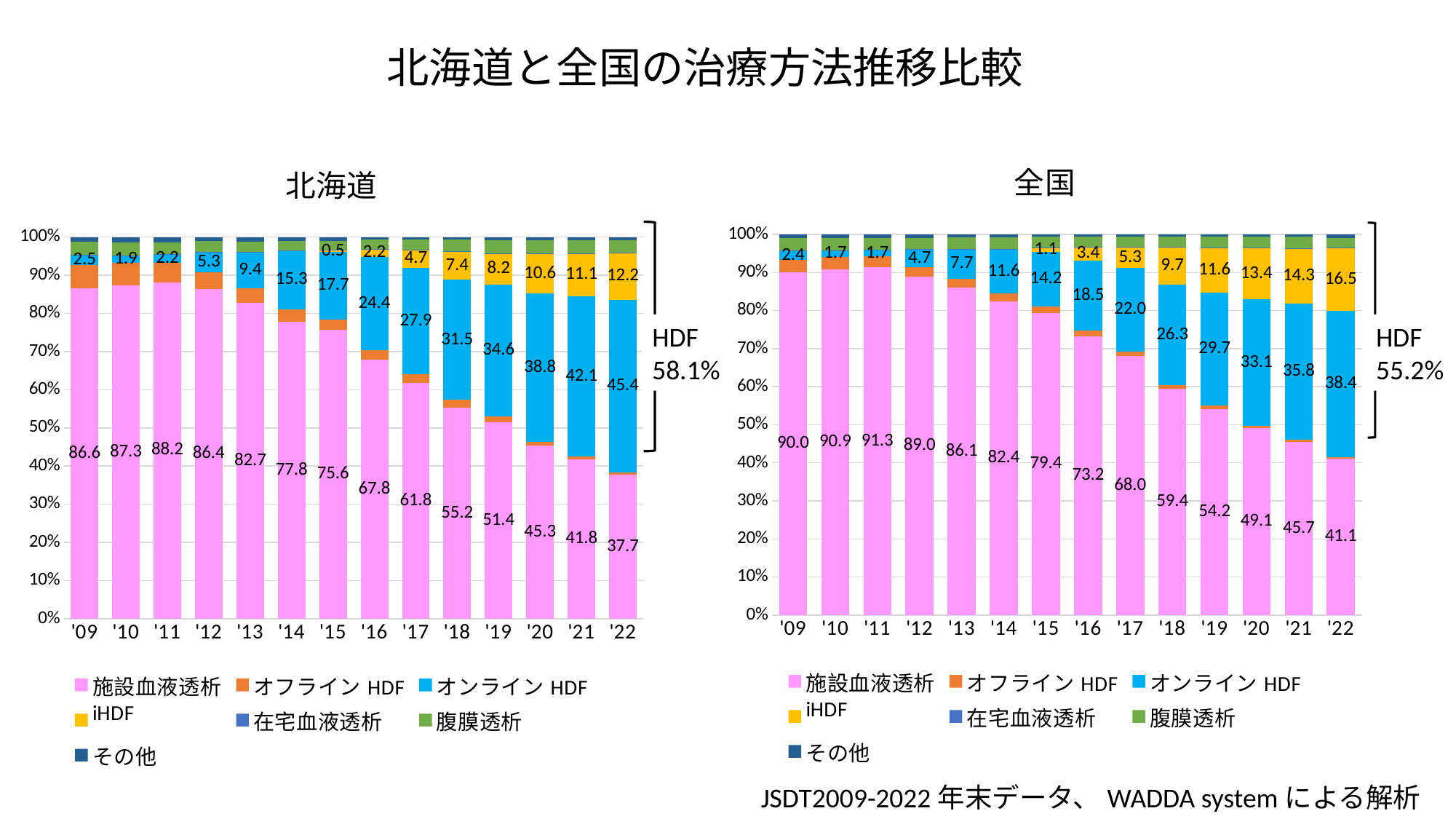
What HDF percentage is annotated beside the 全国 chart? 55.2% What kind of chart is the 北海道 chart? Stacked bar chart In the 北海道 chart, what is the value of 施設血液透析 for '22? 37.7 In the 北海道 chart, what is the value of iHDF for '20? 10.6 How many years are shown on the x axis of the 全国 chart? 14 In the 全国 chart, does the value of 施設血液透析 rise or fall from '12 to '22? Fall Which is larger: the オンライン HDF value for '22 in the 北海道 chart or in the 全国 chart? 北海道 In the 北海道 chart, which year has the lowest value for オンライン HDF? '10 In the 北海道 chart, what is the difference between the 施設血液透析 values for '09 and '22? 48.9 How many series does the legend of the 北海道 chart list? 7 In the 全国 chart, what is the value of オンライン HDF for '22? 38.4 In the 全国 chart, which year has the highest value for 施設血液透析? '11